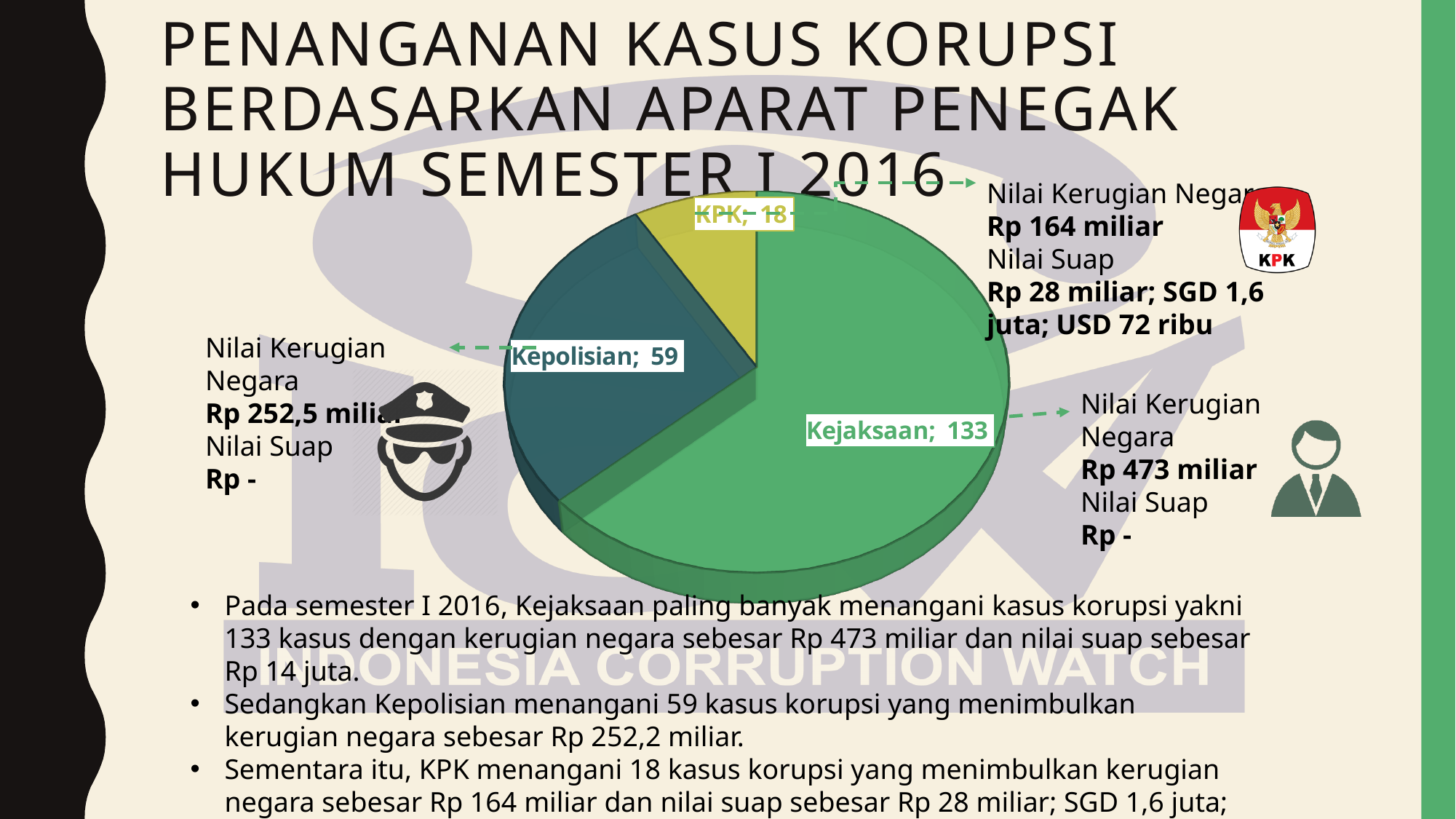
What is the total number of cases across all three slices of the pie chart? 210 Which law enforcement agency has the largest slice in the pie chart? Kejaksaan What is the difference between the number of cases for Kepolisian and KPK in the pie chart? 41 Which has more cases in the pie chart, Kepolisian or KPK? Kepolisian What kind of chart is shown on the slide? Pie chart What colour is the KPK slice in the pie chart? Yellow How many cases does the pie chart show for Kejaksaan? 133 How many slices does the pie chart have? 3 Which law enforcement agency has the smallest slice in the pie chart? KPK How many cases does the pie chart show for KPK? 18 What is the difference between the number of cases for Kejaksaan and Kepolisian in the pie chart? 74 How many cases does the pie chart show for Kepolisian? 59